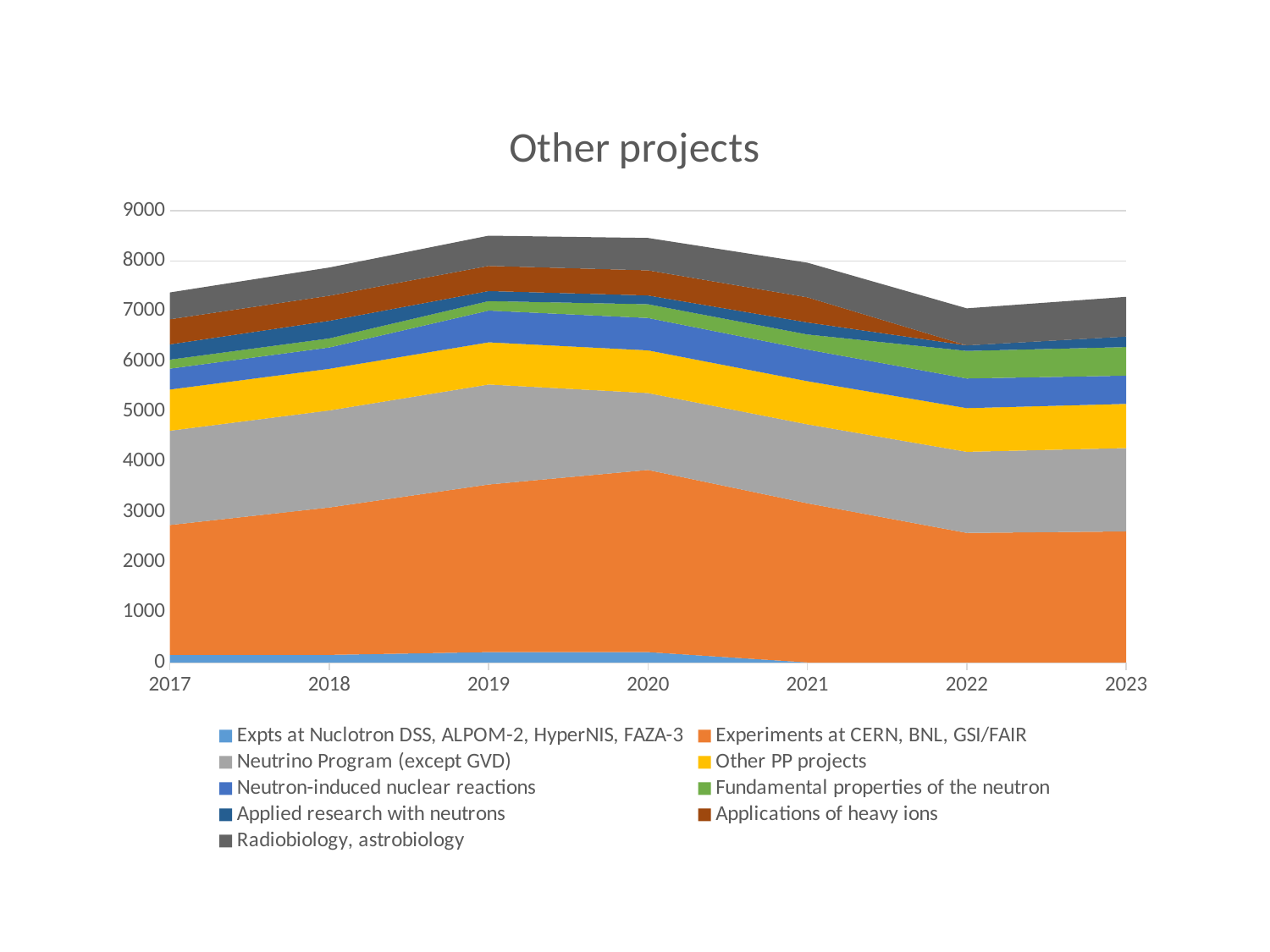
How many years are shown along the x axis? 7 What is the title of the chart? Other projects Which series occupies the largest area of the chart? Experiments at CERN, BNL, GSI/FAIR Does the total stacked value rise or fall from 2017 to 2019? rise What kind of chart is shown on the slide? Stacked area chart Is the total stacked value for 2022 greater or less than 8000? less Does the total stacked value rise or fall from 2019 to 2022? fall Is the total stacked value for 2019 greater or less than 8000? greater How many series does the legend list? 9 Is the total stacked value for 2022 greater or less than 6000? greater Which year has the lowest total stacked value? 2022